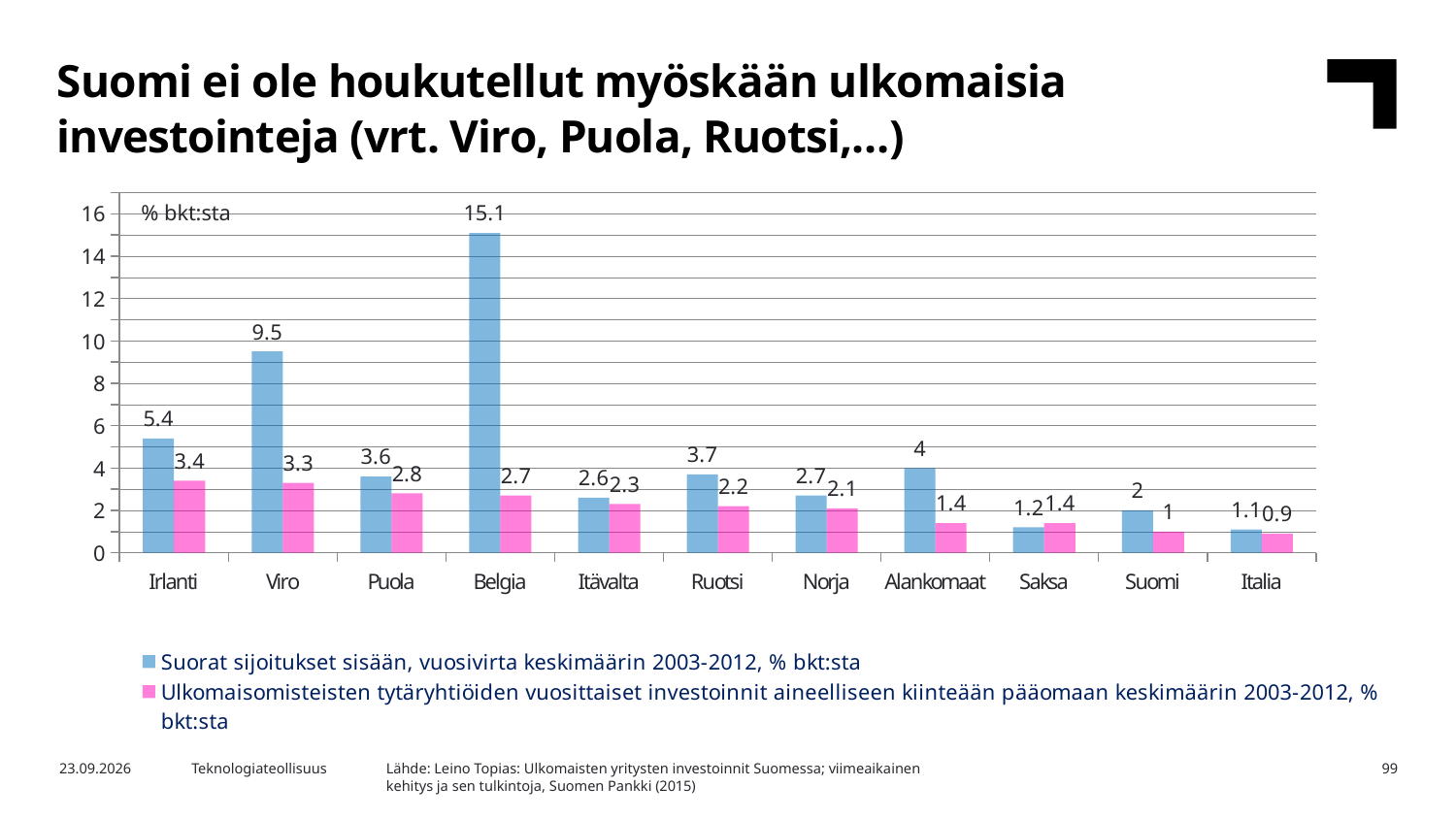
Which is larger: the 'Suorat sijoitukset sisään' value for Irlanti or for Alankomaat? Irlanti What is the value of the 'Suorat sijoitukset sisään' series for Belgia? 15.1 Is the 'Suorat sijoitukset sisään' value for Belgia greater or less than 14? greater How many series does the chart legend list? 2 What is the value of the 'Suorat sijoitukset sisään' series for Viro? 9.5 Which country has the highest value in the 'Suorat sijoitukset sisään' series? Belgia What is the value of the 'Ulkomaisomisteisten tytäryhtiöiden vuosittaiset investoinnit' series for Suomi? 1 What kind of chart is shown on the slide? Bar chart Which country has the lowest value in the 'Ulkomaisomisteisten tytäryhtiöiden vuosittaiset investoinnit' series? Italia What unit label is shown at the top left of the chart's plot area? % bkt:sta What is the difference between the 'Suorat sijoitukset sisään' values for Viro and Suomi? 7.5 How many countries are shown on the x axis of the chart? 11